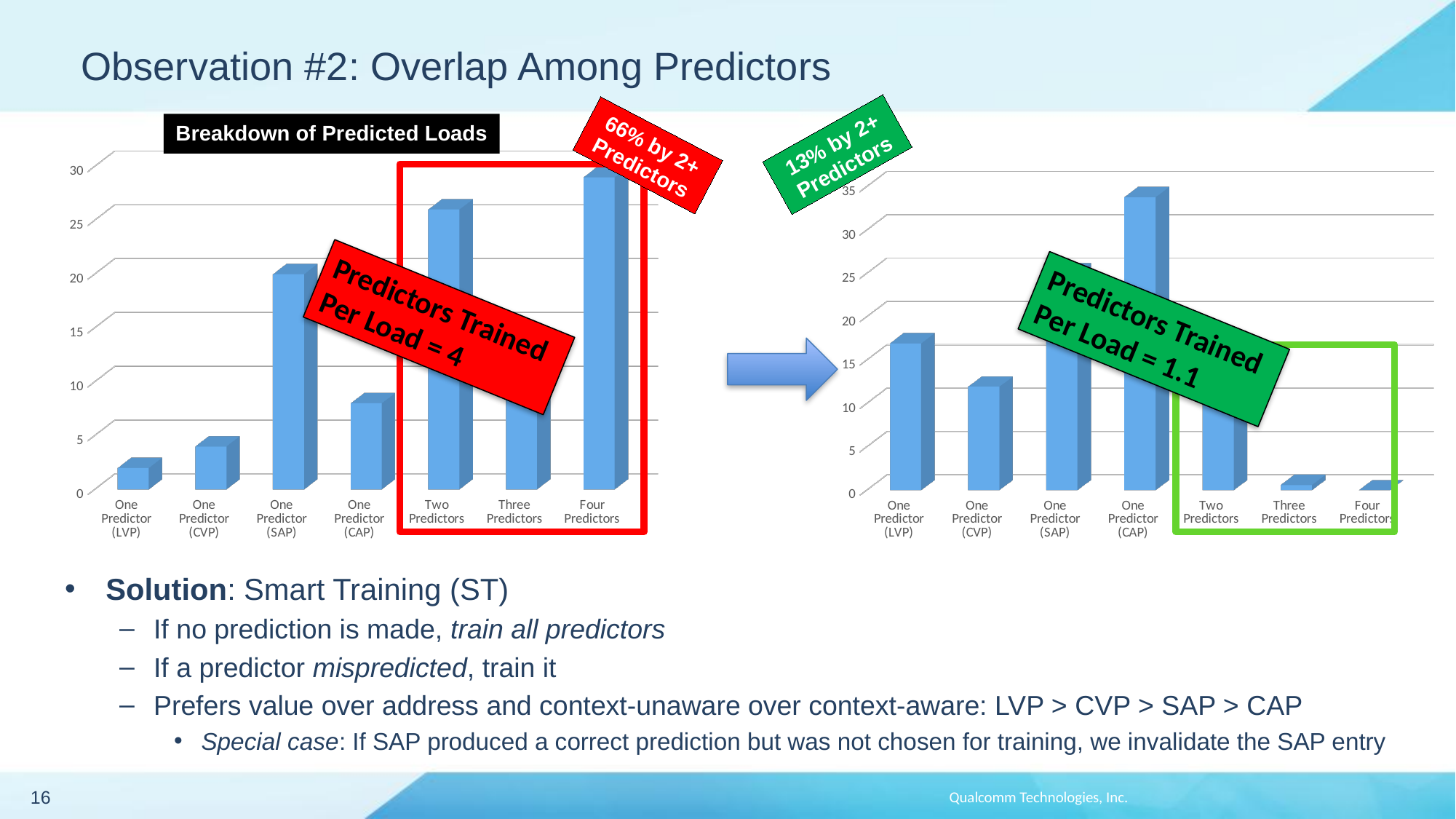
In the right chart, which category has the highest value? One Predictor (CAP) In the left chart (Breakdown of Predicted Loads), how many categories are shown on the x axis? 7 In the right chart, is the value for Three Predictors greater or less than 5? less In the left chart (Breakdown of Predicted Loads), is the value for One Predictor (SAP) greater or less than 15? greater In the left chart (Breakdown of Predicted Loads), which category has the highest value? Four Predictors In the right chart, is the value for One Predictor (LVP) greater or less than 15? greater In the left chart (Breakdown of Predicted Loads), which category has the lowest value? One Predictor (LVP) What kind of chart is the left chart titled 'Breakdown of Predicted Loads'? bar chart In the right chart, which is larger: One Predictor (LVP) or One Predictor (CVP)? One Predictor (LVP) What is the title shown in the black box above the left chart? Breakdown of Predicted Loads In the left chart (Breakdown of Predicted Loads), which is larger: One Predictor (SAP) or One Predictor (CVP)? One Predictor (SAP)